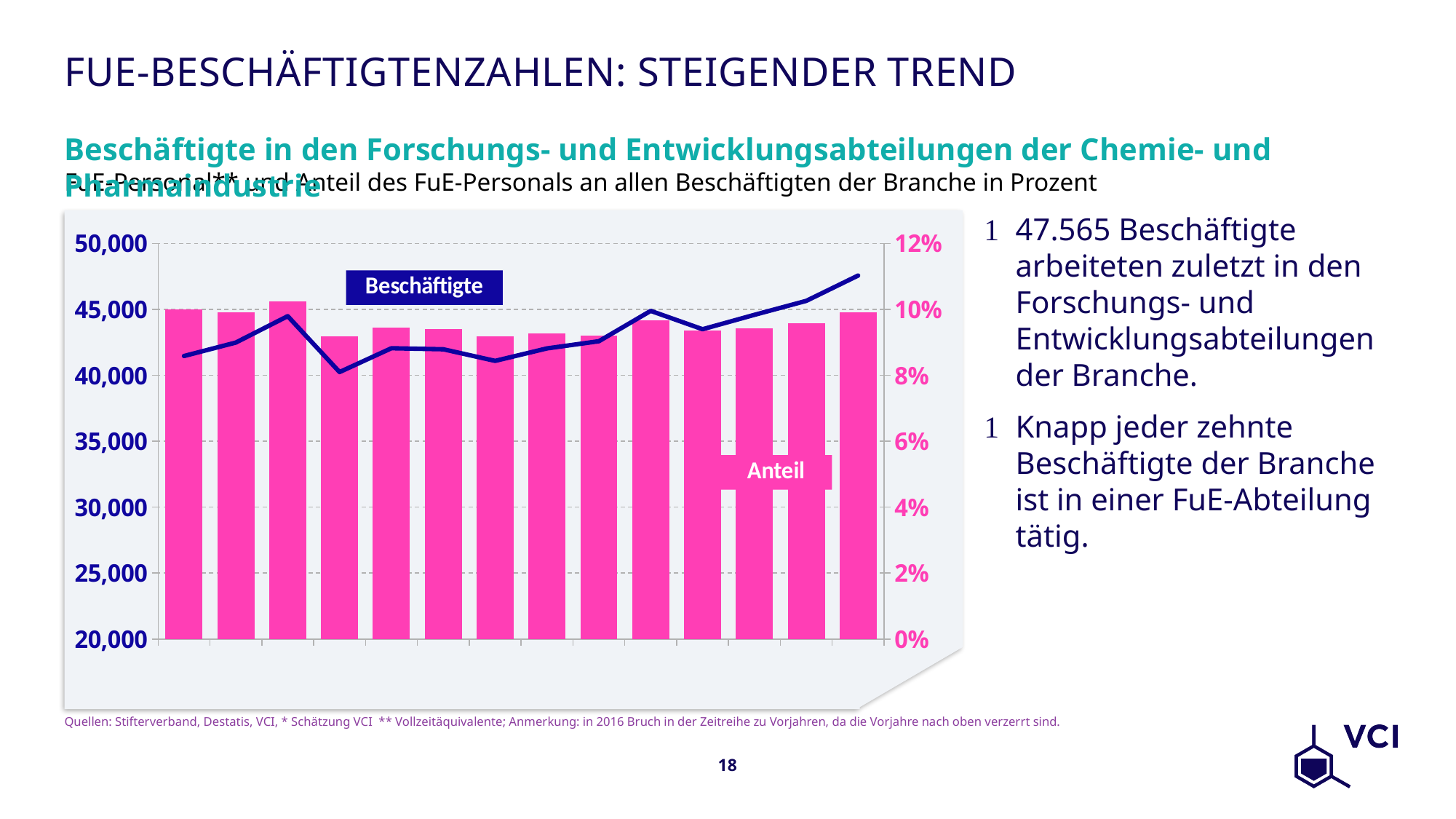
How many bars are plotted in the chart? 14 Which bar is the tallest in the chart? The third bar from the left What colour are the bars in the chart? Pink What kind of chart is shown on the slide? A bar chart combined with a line How many data series does the chart show? 2 Which series is drawn as bars, Beschäftigte or Anteil? Anteil What is the highest value shown on the right-hand percentage axis? 12%